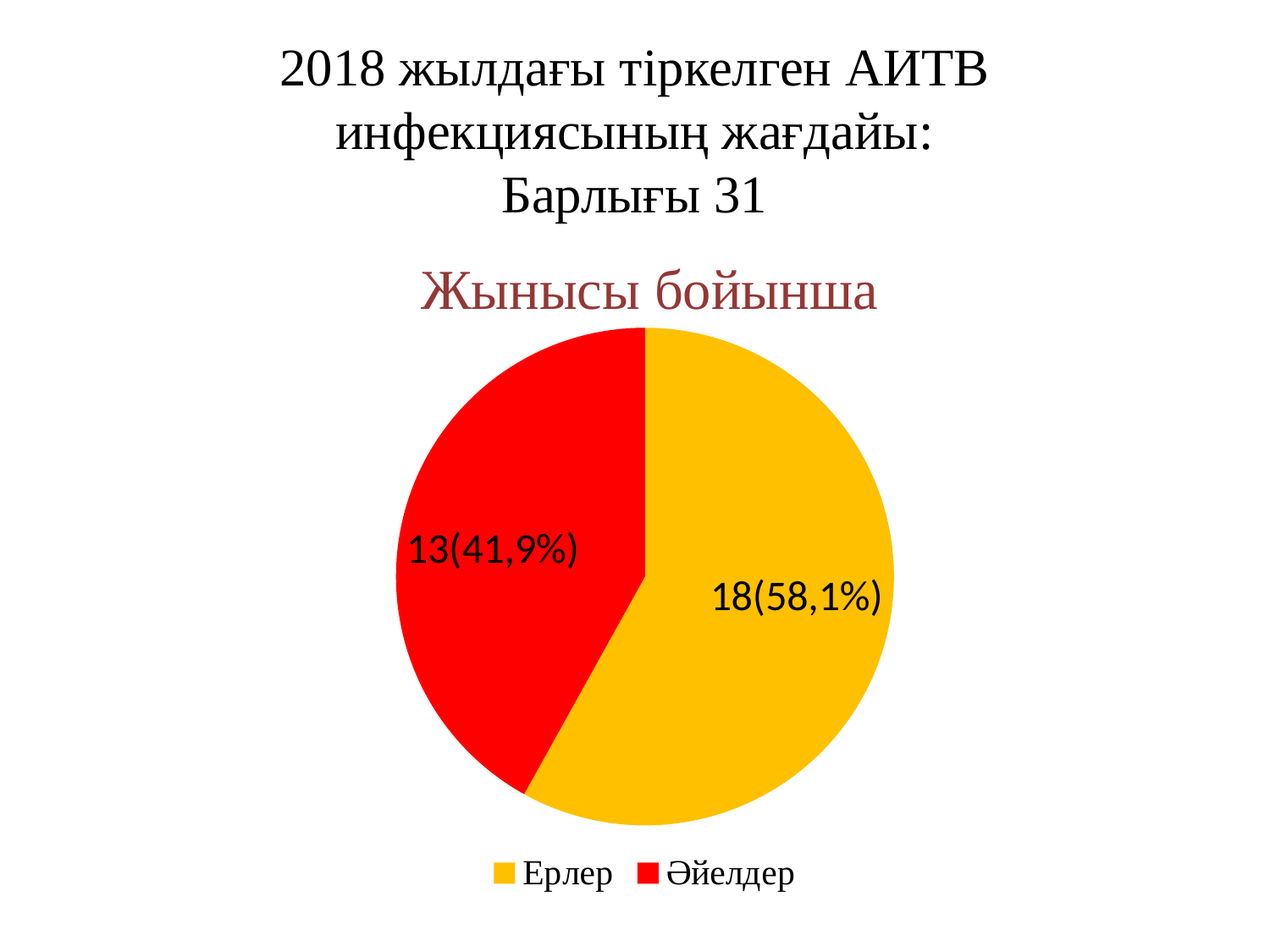
What is the data label shown on the Әйелдер slice of the pie chart? 13(41,9%) What is the difference in count between the Ерлер and Әйелдер slices? 5 Which category has the larger slice in the pie chart? Ерлер What kind of chart is shown on the slide? pie chart Is the Ерлер slice larger or smaller than the Әйелдер slice? larger How many slices does the pie chart have? 2 What share of the pie does the Ерлер slice represent? 58,1% What is the data label shown on the Ерлер slice of the pie chart? 18(58,1%) How many entries does the legend list? 2 What is the title of the chart? Жынысы бойынша Which category has the smaller slice in the pie chart? Әйелдер What colour is the Әйелдер slice in the pie chart? red